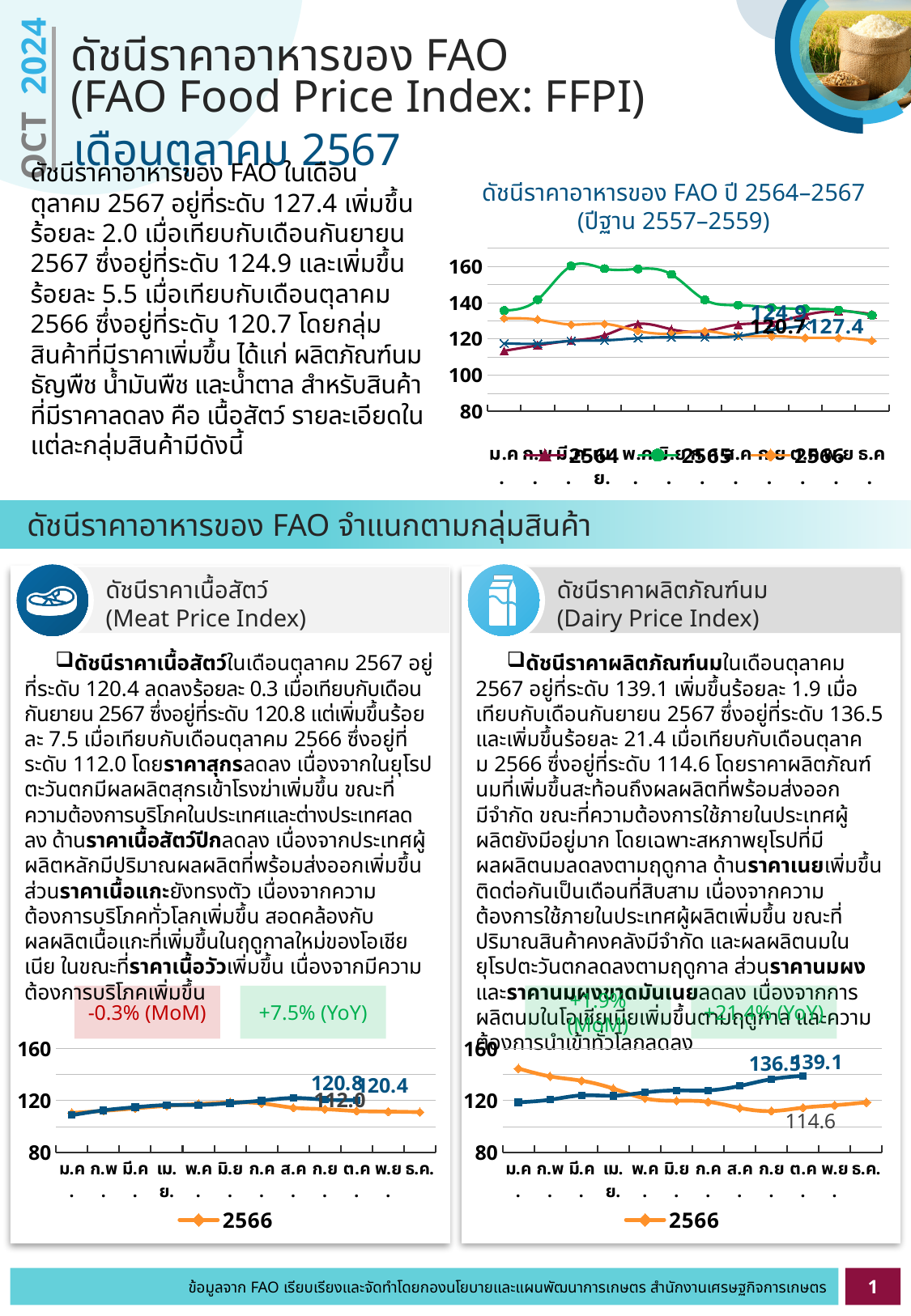
In the top-right chart, is the peak of the green 2565 series greater or less than 140? greater In the Dairy Price Index chart (bottom right), which labeled October value is larger: 2567 (139.1) or 2566 (114.6)? 2567 In the top-right chart, what value is labeled for the 2566 series in October? 120.7 What kind of chart is the top-right chart (ดัชนีราคาอาหารของ FAO ปี 2564–2567)? line chart In the Meat Price Index chart (bottom left), what value is labeled for the 2566 series in October? 112.0 In the top-right chart (ดัชนีราคาอาหารของ FAO ปี 2564–2567), what value is labeled at the end of the blue 2567 line for October? 127.4 In the Dairy Price Index chart (bottom right), what value is labeled for October 2567? 139.1 In the top-right chart, what is the difference between the labeled October 2567 value (127.4) and the labeled October 2566 value (120.7)? 6.7 In the top-right chart, what value is labeled for the 2567 series in September? 124.9 In the Meat Price Index chart (bottom left), what is the difference between the labeled September 2567 value (120.8) and the labeled October 2567 value (120.4)? 0.4 In the Meat Price Index chart (bottom left), what value is labeled for October 2567? 120.4 In the Dairy Price Index chart (bottom right), what is the difference between the labeled October 2567 value (139.1) and the labeled October 2566 value (114.6)? 24.5